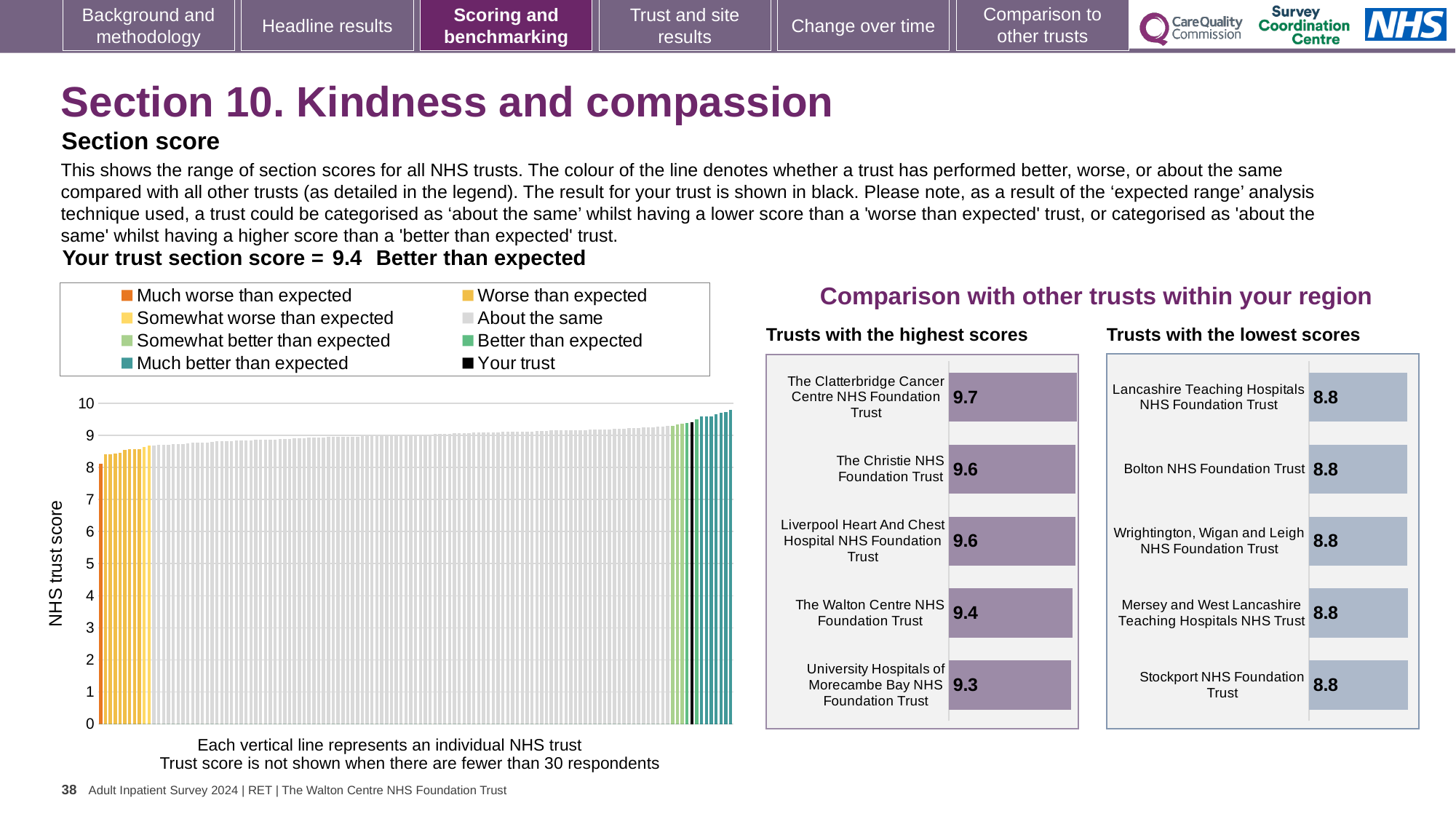
In the 'Trusts with the highest scores' chart, what is the score for University Hospitals of Morecambe Bay NHS Foundation Trust? 9.3 In the 'NHS trust score' chart on the left, is the value of the leftmost (lowest) bar greater or less than 9? less What kind of chart is the 'NHS trust score' chart on the left of the slide? Bar chart In the 'Trusts with the highest scores' chart, what is the difference between the scores of The Clatterbridge Cancer Centre NHS Foundation Trust and The Walton Centre NHS Foundation Trust? 0.3 In the 'Trusts with the highest scores' chart, which trust has the lowest score? University Hospitals of Morecambe Bay NHS Foundation Trust How many entries does the legend of the 'NHS trust score' chart on the left list? 8 In the 'NHS trust score' chart on the left, do the bar values rise or fall from left to right? Rise In the 'Trusts with the lowest scores' chart, what is the score for Stockport NHS Foundation Trust? 8.8 How many trusts are shown in the 'Trusts with the lowest scores' chart? 5 In the 'Trusts with the highest scores' chart, which trust has the highest score? The Clatterbridge Cancer Centre NHS Foundation Trust In the 'Trusts with the highest scores' chart, which has the higher score: The Christie NHS Foundation Trust or The Walton Centre NHS Foundation Trust? The Christie NHS Foundation Trust In the 'Trusts with the highest scores' chart, what is the score for The Clatterbridge Cancer Centre NHS Foundation Trust? 9.7